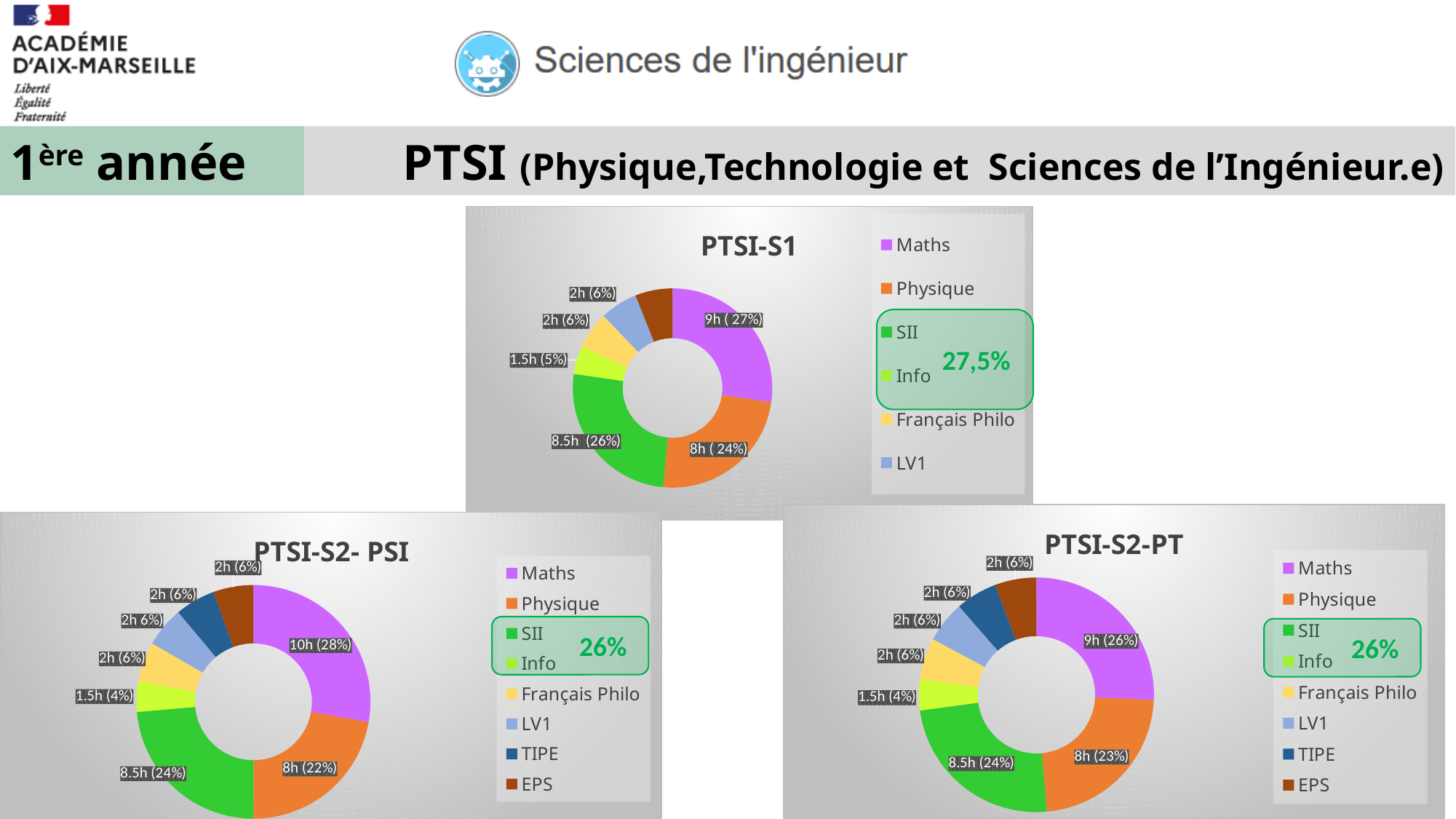
How many entries does the legend of the PTSI-S2- PSI chart list? 8 In the PTSI-S2- PSI chart, which subject has the smallest slice? Info In the PTSI-S1 chart, what share of the total does SII represent? 26% In the PTSI-S2-PT chart, which is larger, the Physique slice or the SII slice? SII In the PTSI-S2- PSI chart, what share of the total does Physique represent? 22% How many entries does the legend of the PTSI-S1 chart list? 6 In the PTSI-S1 chart, which subject has the largest slice? Maths What kind of chart is the PTSI-S1 chart? Pie chart (doughnut) In the PTSI-S1 chart, how many hours are shown for Maths? 9h In the PTSI-S2- PSI chart, how many hours are shown for Maths? 10h In the PTSI-S2-PT chart, what share of the total does Maths represent? 26% In the PTSI-S2-PT chart, what is the difference in hours between Maths and Physique? 1h